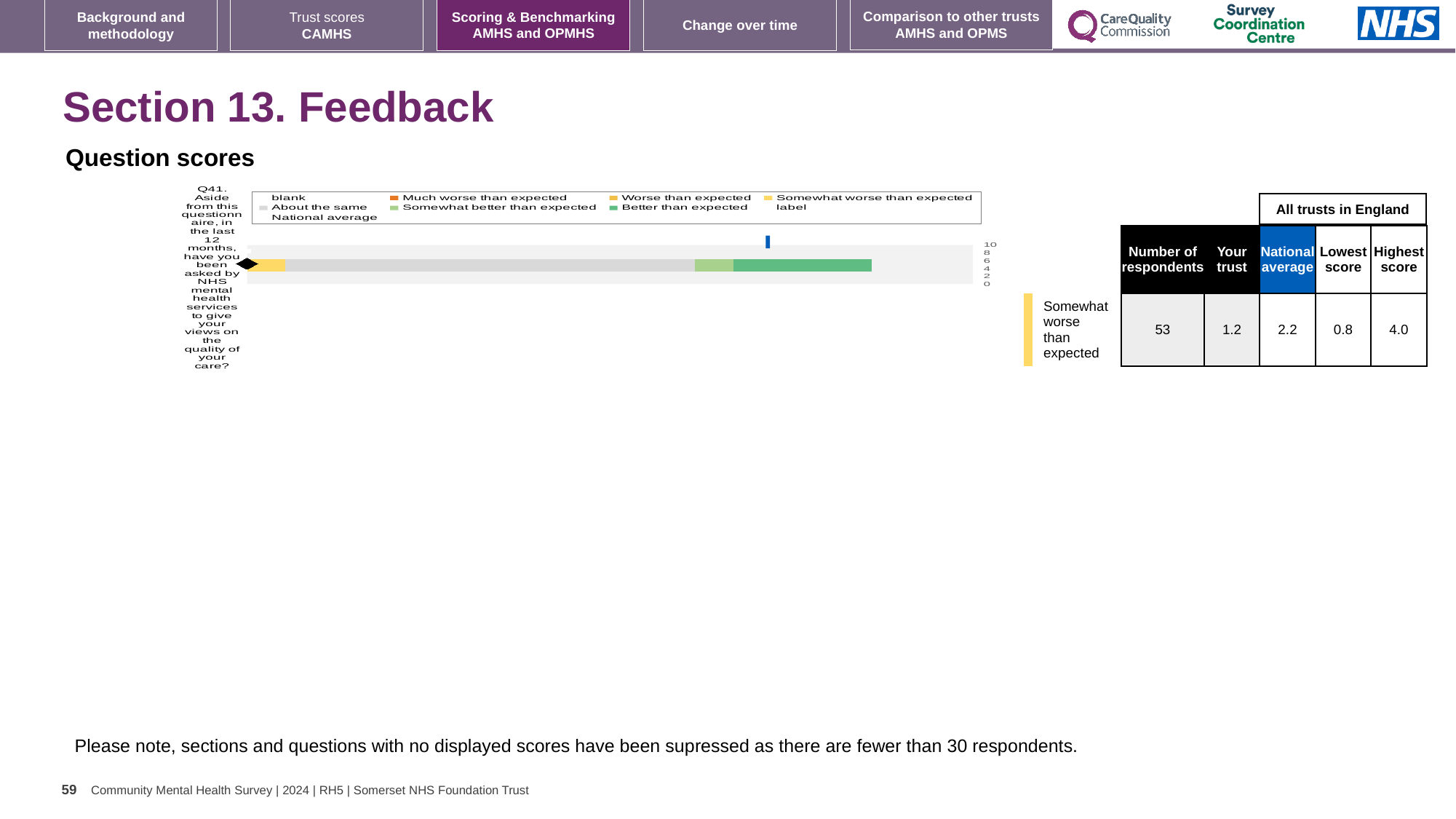
What is the 'Your trust' score for Q41 shown next to the chart? 1.2 What is the lowest score among all trusts in England for Q41? 0.8 Which benchmark category is the trust's Q41 score assigned to? Somewhat worse than expected How many respondents answered Q41? 53 What is the highest score among all trusts in England for Q41? 4.0 What is the difference between the national average and the trust's score for Q41? 1.0 What is the national average score for Q41? 2.2 What type of chart is used to show the Q41 question score? bar chart Is the trust's score for Q41 greater or less than 2 on the chart axis? less Which is higher for Q41, the trust's score or the national average? national average How many questions are plotted in the Question scores chart? 1 What colour represents 'Better than expected' in the chart legend? green